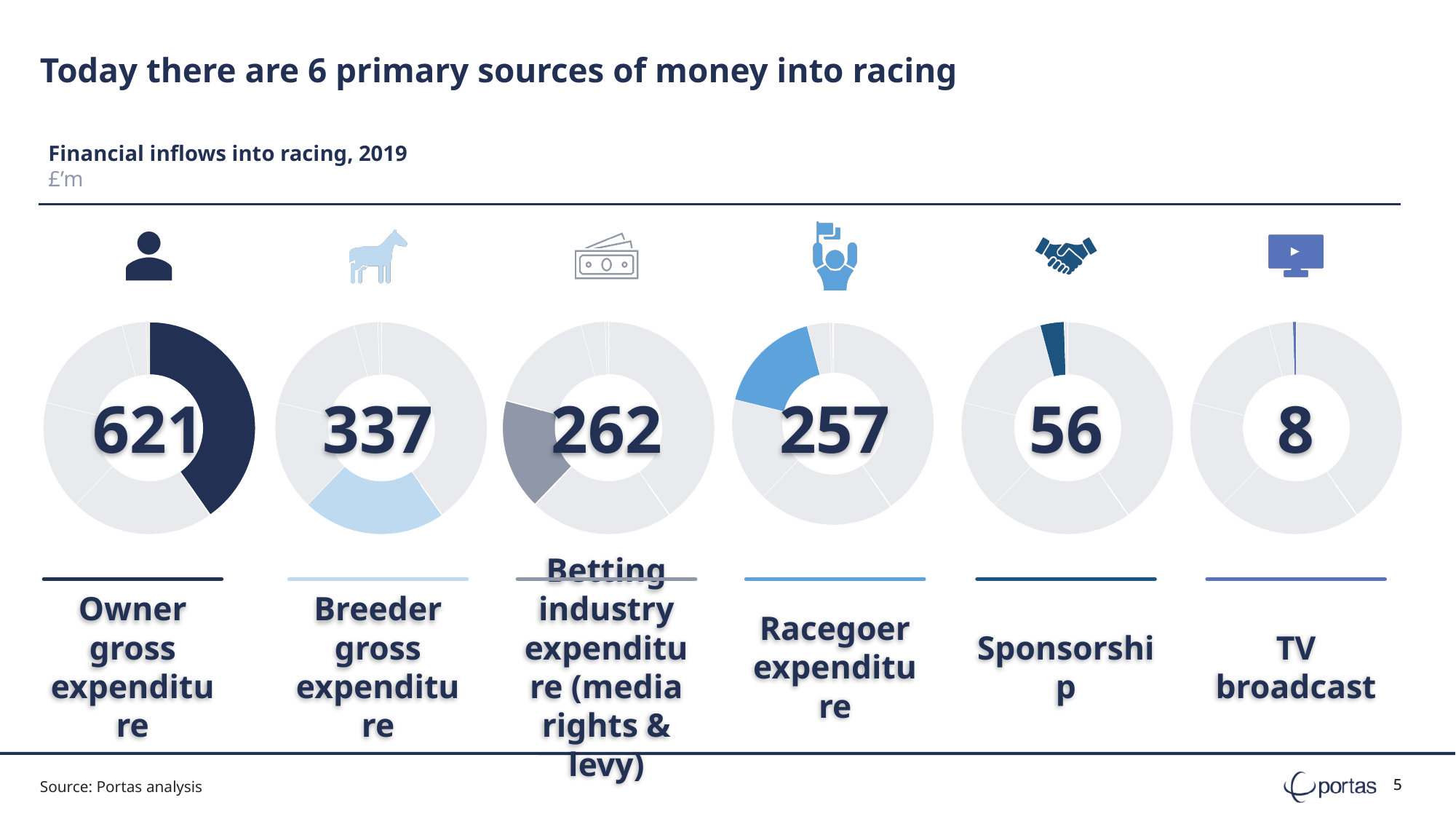
What is the difference between Owner gross expenditure and Breeder gross expenditure? 284 Which is larger, Betting industry expenditure (media rights & levy) or Racegoer expenditure? Betting industry expenditure (media rights & levy) Which source of money into racing has the lowest value? TV broadcast How many sources of money into racing are shown on the slide? 6 What unit is stated for the financial inflows into racing? £'m What is the value for Owner gross expenditure? 621 What is the value for Breeder gross expenditure? 337 Which source of money into racing has the highest value? Owner gross expenditure What is the value for Sponsorship? 56 What kind of chart is used to show each source of money into racing? Donut chart What is the value for TV broadcast? 8 What is the value for Betting industry expenditure (media rights & levy)? 262